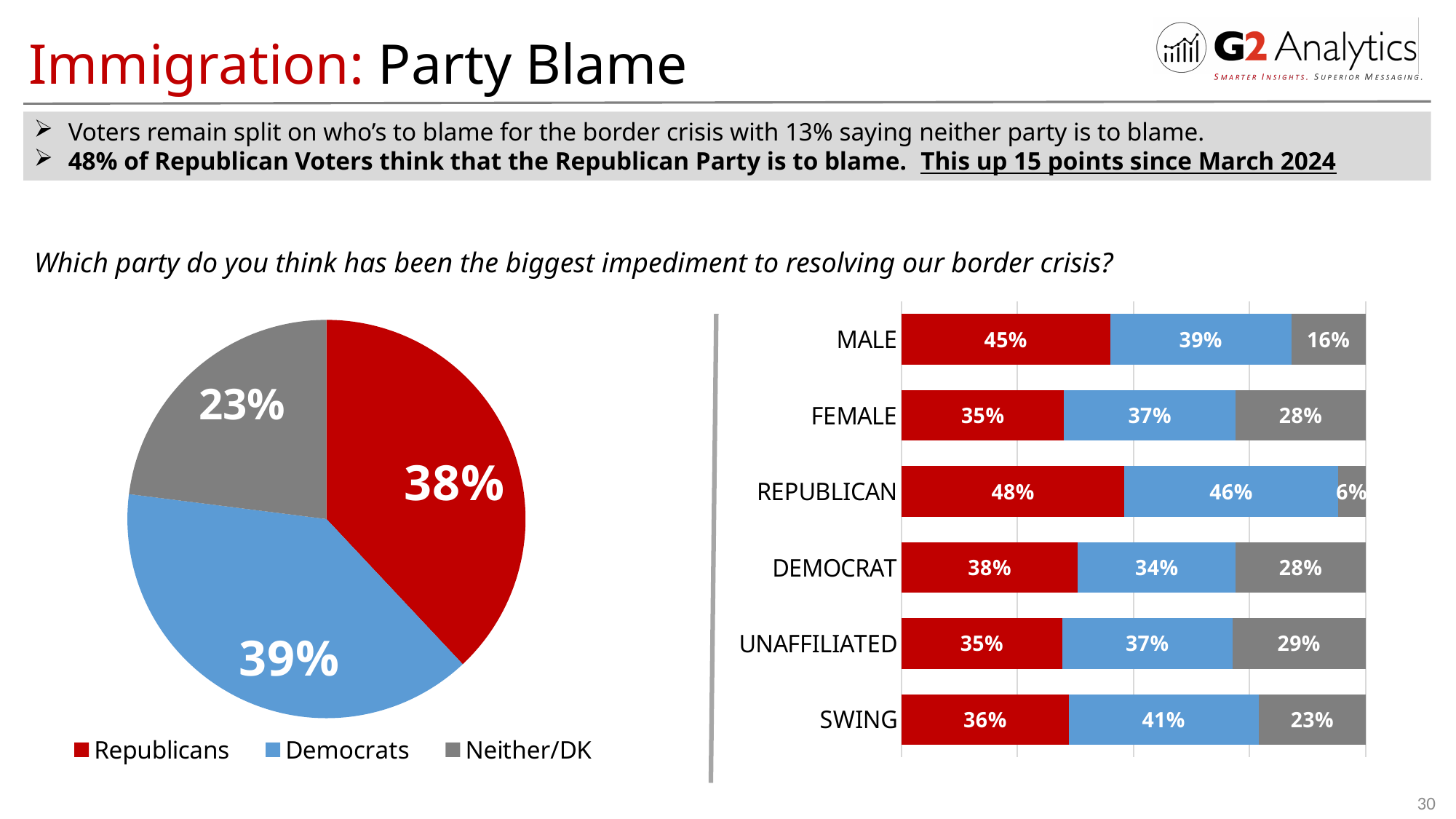
What type of chart is on the right side of the slide? Stacked bar chart In the pie chart on the left, how many slices are there? 3 In the bar chart on the right, what percentage of Swing respondents blame Democrats? 41% In the pie chart on the left, what share of respondents blame Republicans? 38% In the bar chart on the right, how many groups are shown? 6 In the bar chart on the right, what percentage of Republican respondents blame the Republican Party? 48% In the bar chart on the right, what is the difference between the Male and Female Republicans values? 10% In the pie chart on the left, what share of respondents answered Neither/DK? 23% In the bar chart on the right, which is larger for Democrat respondents: the Republicans value or the Democrats value? Republicans In the bar chart on the right, which group has the lowest Neither/DK value? REPUBLICAN In the pie chart on the left, which category has the smallest slice? Neither/DK In the bar chart on the right, which group has the highest Republicans value? REPUBLICAN